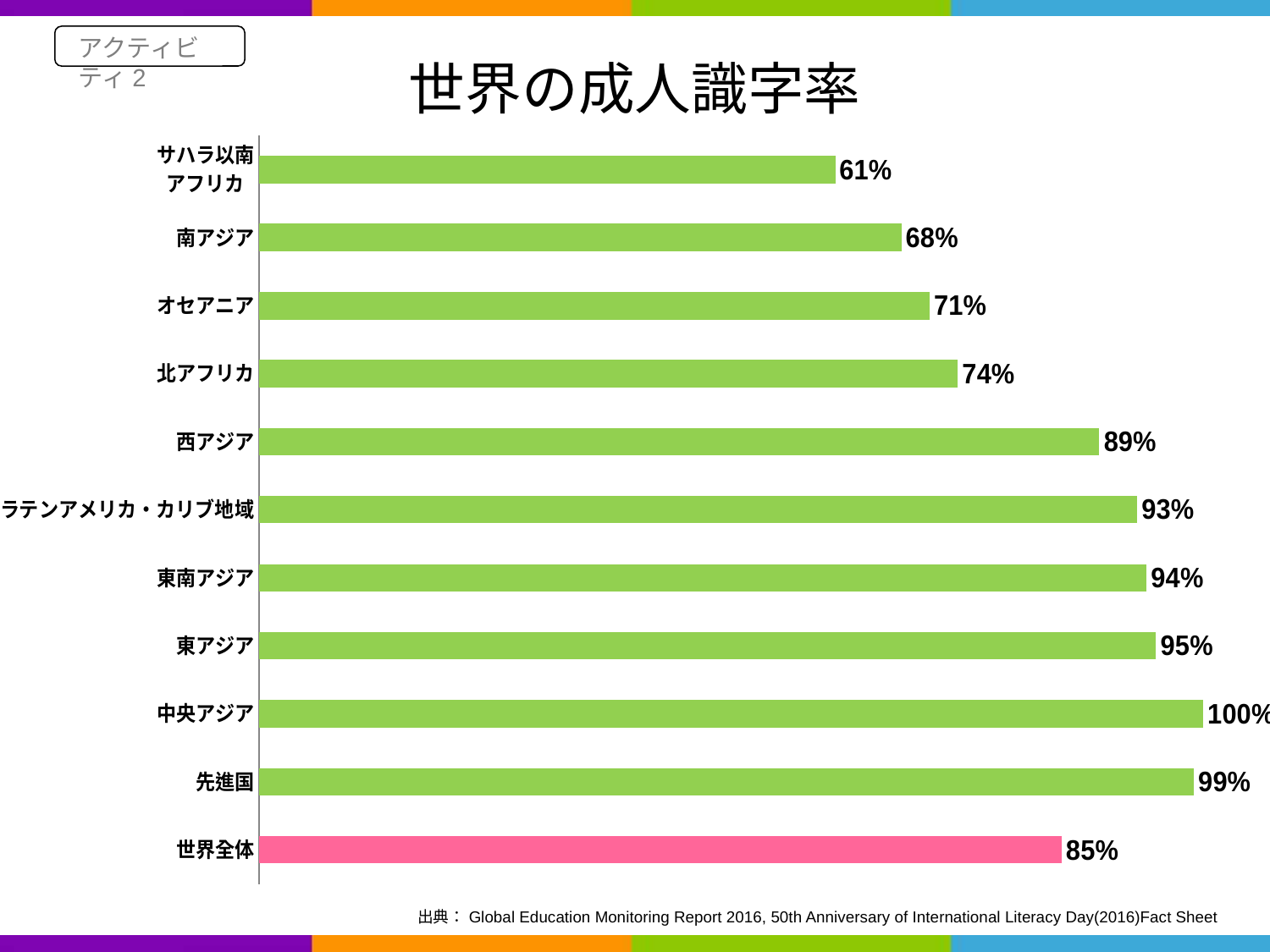
What is the adult literacy rate shown for サハラ以南アフリカ? 61% What kind of chart is shown on the slide? Bar chart What is the difference between the values for 中央アジア and 世界全体? 15% Which category has the highest value in the chart? 中央アジア What is the title of the chart? 世界の成人識字率 What is the value shown for 東南アジア? 94% What value is shown for 世界全体? 85% Which bar is shown in a different colour (pink) from the others? 世界全体 How many categories are shown in the chart? 11 What is the difference between the values for 先進国 and 南アジア? 31% Which category has the lowest value in the chart? サハラ以南アフリカ Which is larger, the value for 西アジア or the value for 北アフリカ? 西アジア